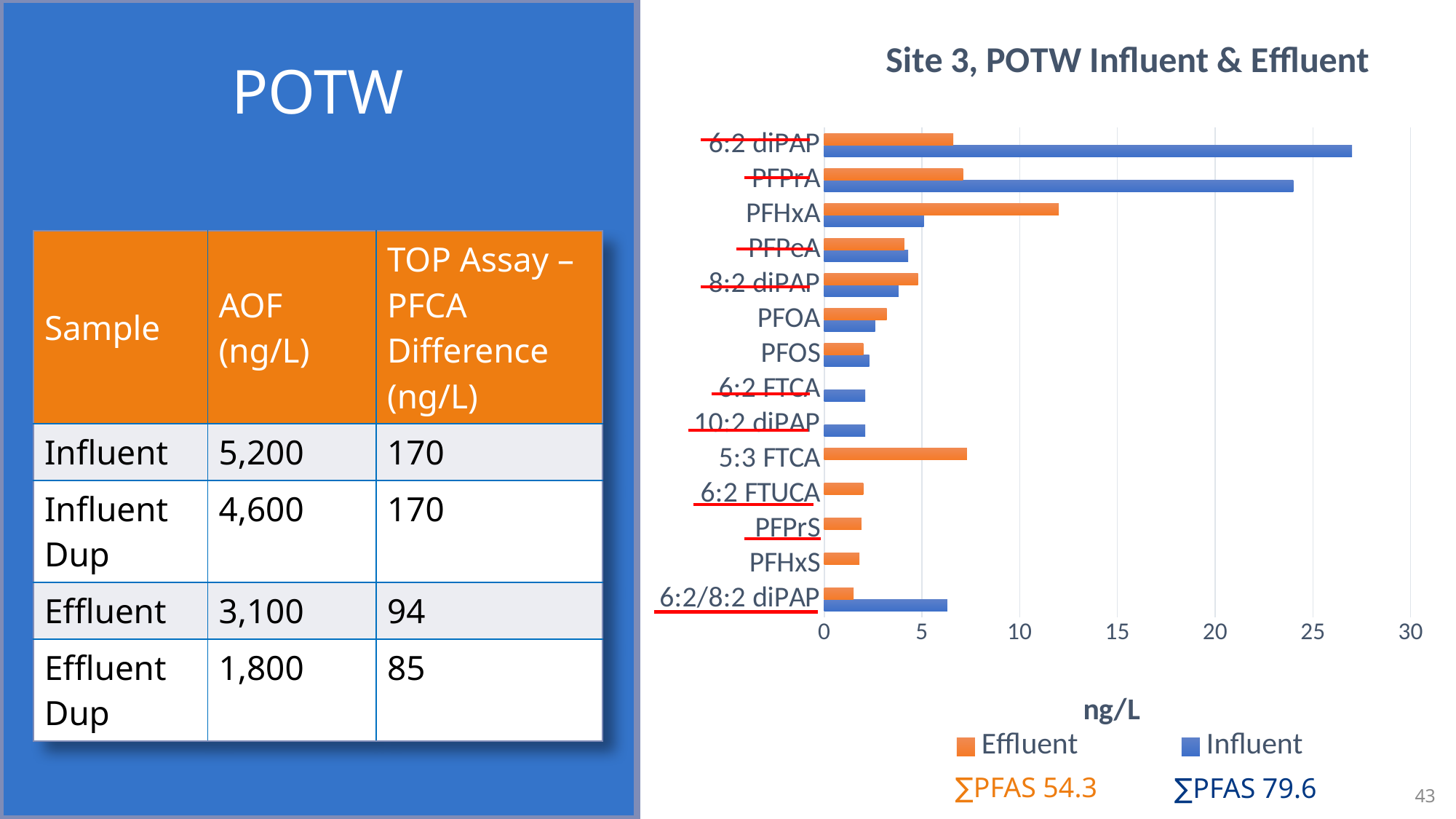
Which compound has the highest Influent value? 6:2 diPAP For PFHxA, which is larger, the Effluent value or the Influent value? Effluent Is the Effluent value for PFOA greater or less than 5? less Is the Influent value for PFPrA greater or less than 20? greater What kind of chart is shown on the slide? bar chart For 6:2 diPAP, which is larger, the Influent value or the Effluent value? Influent How many compounds (categories) are plotted on the chart? 14 Is the Influent value for 6:2 diPAP greater or less than 25? greater How many series does the legend of the chart list? 2 Which compound has the highest Effluent value? PFHxA What unit is shown on the x axis of the chart? ng/L